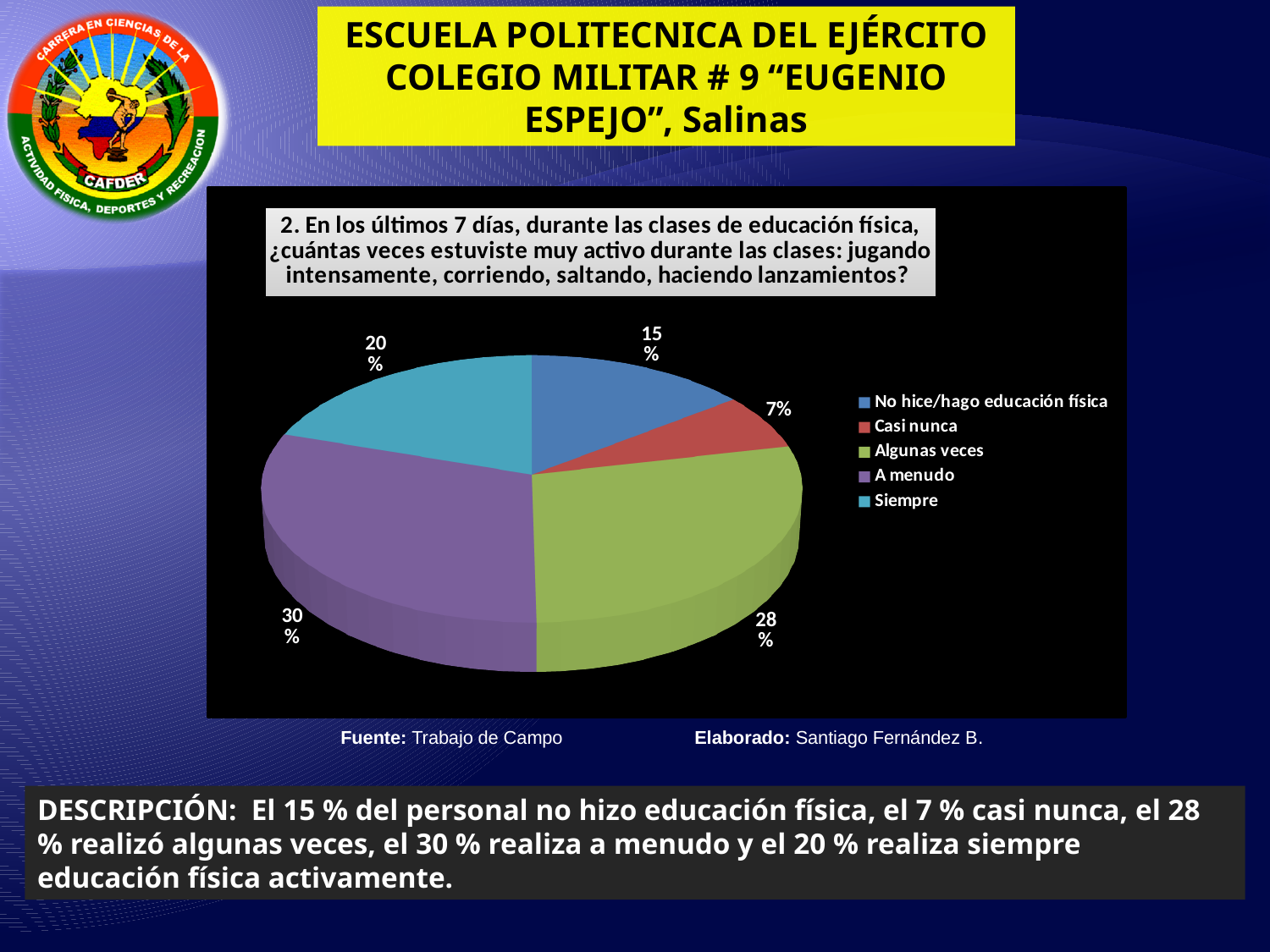
Which is larger, the share for "Algunas veces" or the share for "No hice/hago educación física"? Algunas veces What percentage is shown for "No hice/hago educación física"? 15% What colour is the slice for "A menudo"? Purple How many categories does the legend list? 5 What percentage is shown for "Casi nunca"? 7% Which category has the largest share of the pie? A menudo What percentage is shown for "Siempre"? 20% Which category has the smallest share of the pie? Casi nunca What is the combined share of "Casi nunca" and "Siempre"? 27% What kind of chart is shown on the slide? Pie chart What percentage is shown for "Algunas veces"? 28% What is the difference in percentage points between "A menudo" and "Siempre"? 10